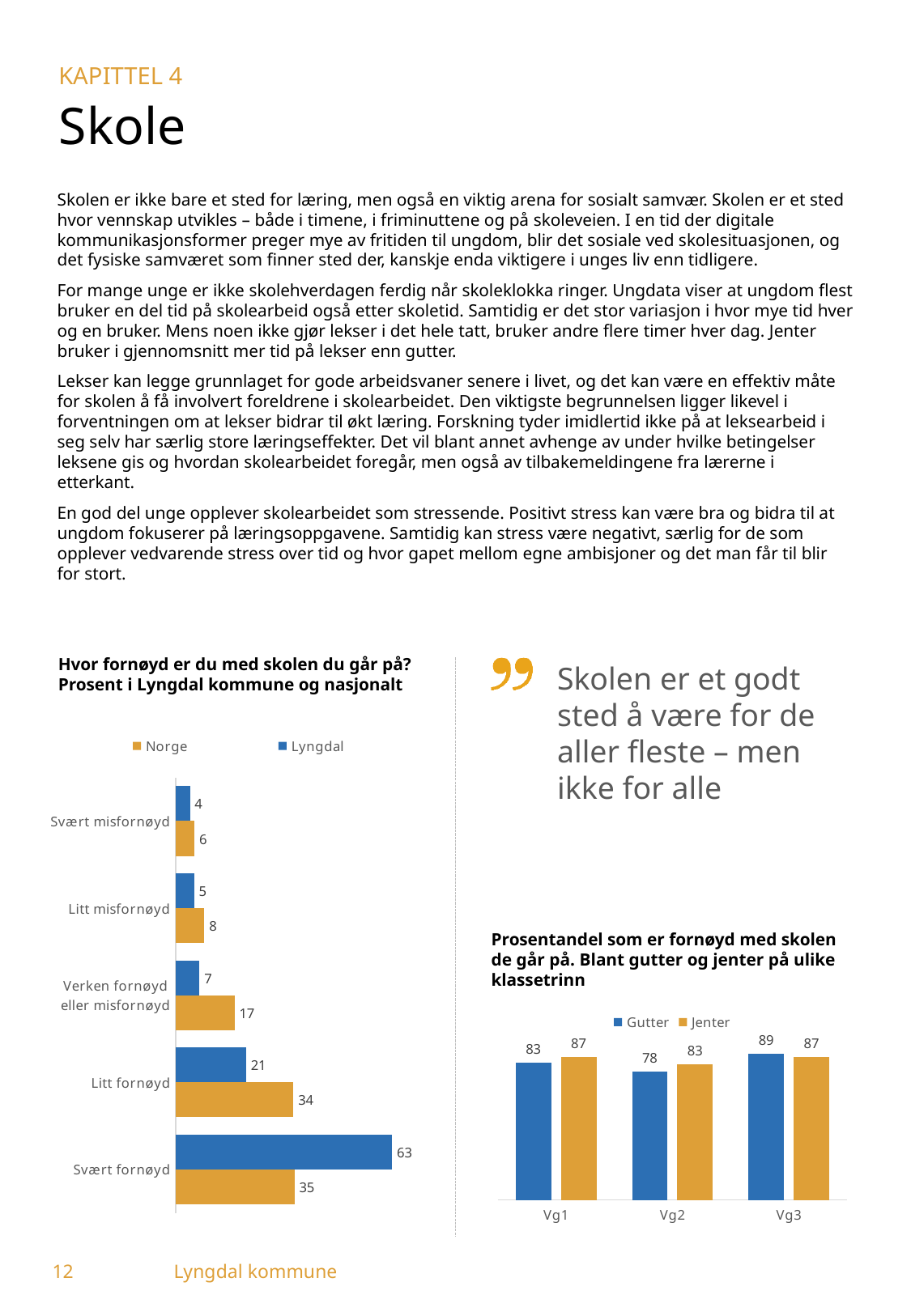
In the chart 'Prosentandel som er fornøyd med skolen de går på', which class level has the highest Gutter value? Vg3 In the chart 'Hvor fornøyd er du med skolen du går på?', what is the difference between the Lyngdal and Norge values for 'Svært fornøyd'? 28 In the chart 'Hvor fornøyd er du med skolen du går på?', which category has the highest Lyngdal value? Svært fornøyd In the chart 'Hvor fornøyd er du med skolen du går på?', which is larger for 'Verken fornøyd eller misfornøyd': Norge or Lyngdal? Norge In the chart 'Hvor fornøyd er du med skolen du går på?', what is the Lyngdal value for 'Svært fornøyd'? 63 In the chart 'Hvor fornøyd er du med skolen du går på?', how many categories are shown? 5 In the chart 'Hvor fornøyd er du med skolen du går på?', which category has the lowest Norge value? Svært misfornøyd What kind of chart is 'Prosentandel som er fornøyd med skolen de går på'? Bar chart In the chart 'Prosentandel som er fornøyd med skolen de går på', what is the Gutter value for Vg2? 78 In the chart 'Prosentandel som er fornøyd med skolen de går på', what is the difference between Jenter and Gutter for Vg2? 5 In the chart 'Hvor fornøyd er du med skolen du går på?', what is the Norge value for 'Litt fornøyd'? 34 In the chart 'Hvor fornøyd er du med skolen du går på?', how many series does the legend list? 2